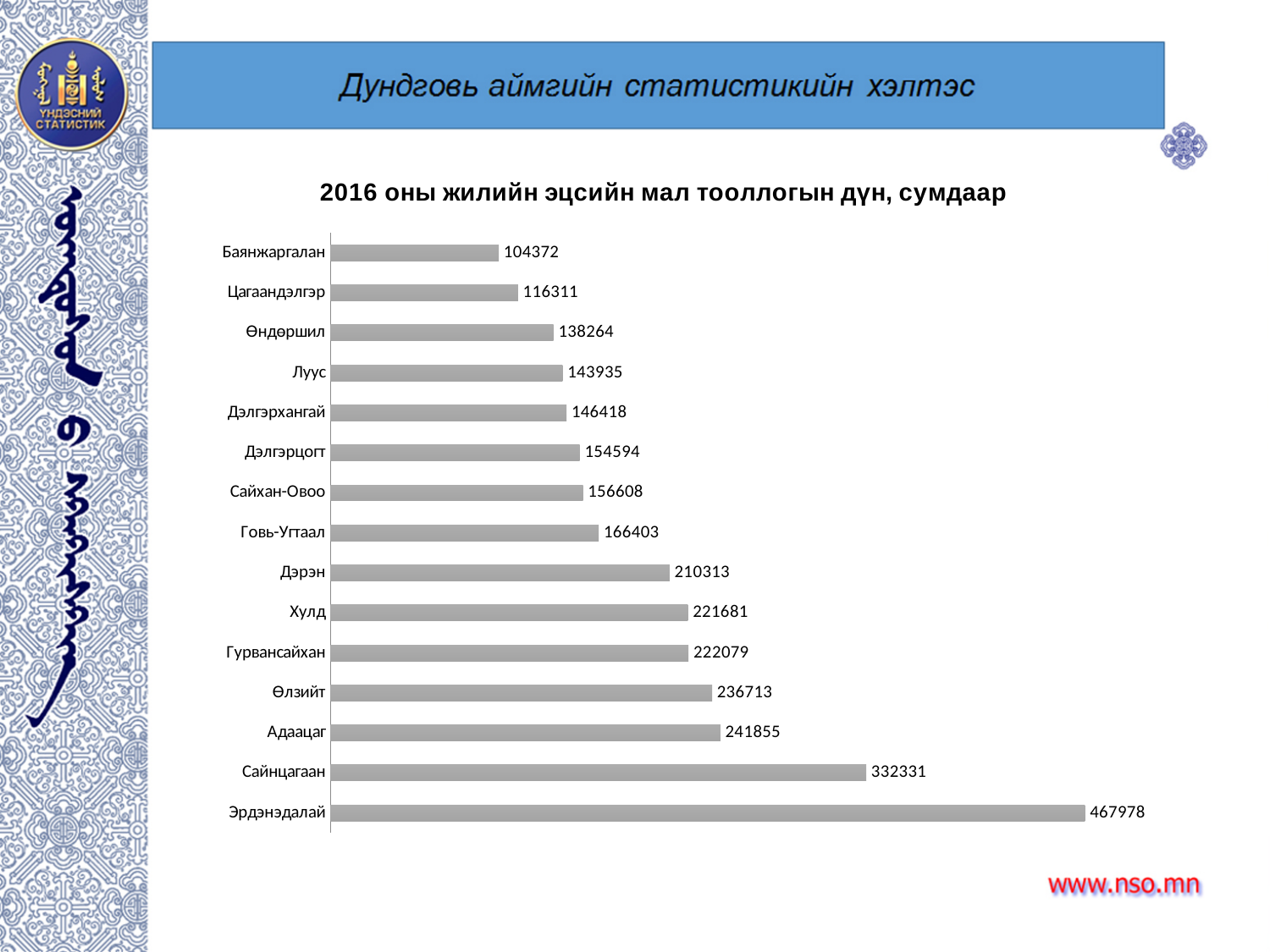
What is the value for Цагаандэлгэр? 116311 Which has a larger value, Дэрэн or Говь-Угтаал? Дэрэн What is the title of the chart? 2016 оны жилийн эцсийн мал тооллогын дүн, сумдаар What is the value for Өлзийт? 236713 What kind of chart is shown on the slide? bar chart How many categories (soums) are shown in the chart? 15 Do the values increase or decrease going from the top bar to the bottom bar? increase Which category has the highest value? Эрдэнэдалай What is the difference between the values for Эрдэнэдалай and Сайнцагаан? 135647 What is the value for Эрдэнэдалай? 467978 Which category has the lowest value? Баянжаргалан What is the value for Сайхан-Овоо? 156608